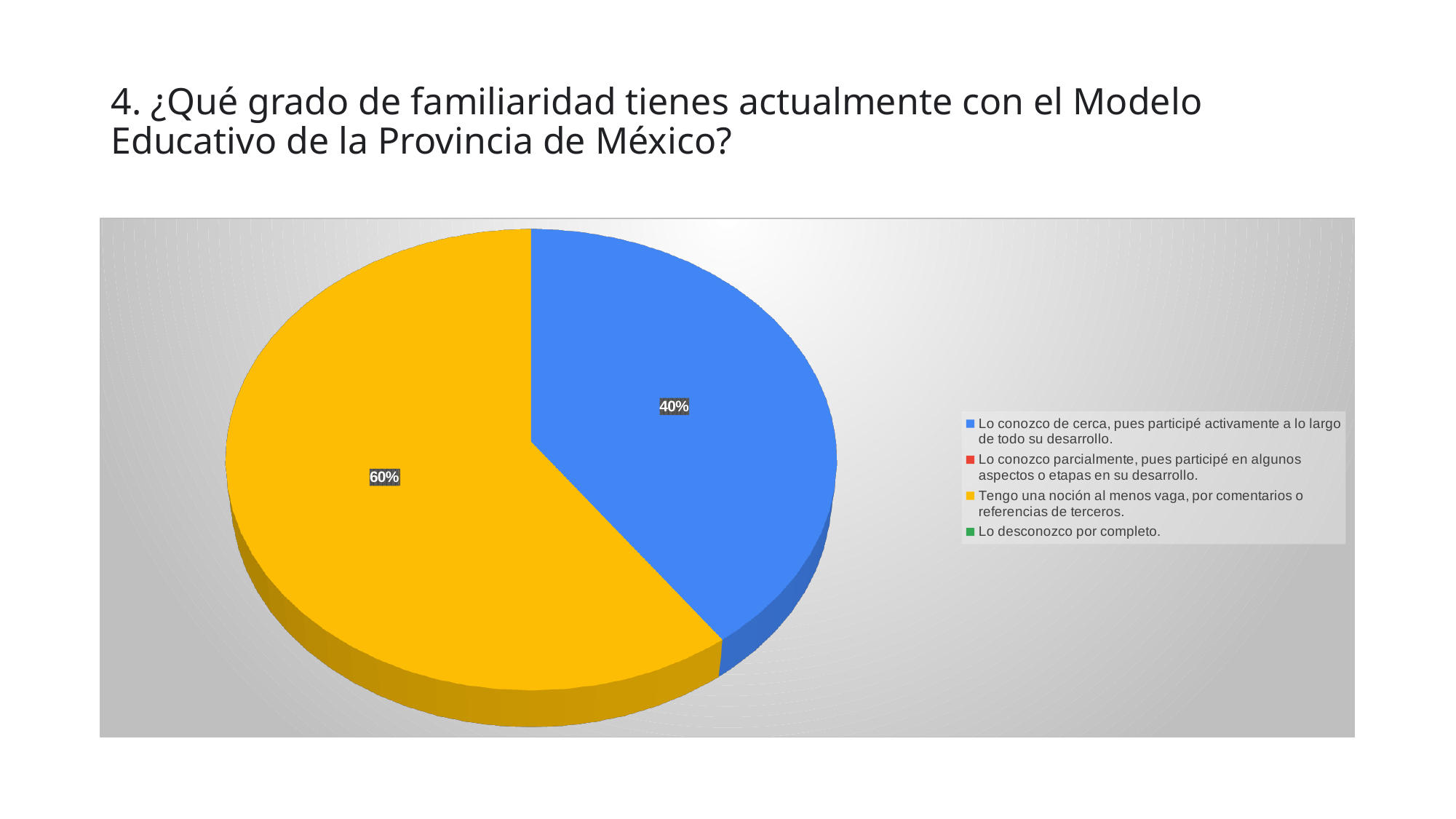
How many slices are visible in the pie? 2 How many entries does the legend list? 4 What colour is the slice labelled 60%? yellow What kind of chart is shown on the slide? pie chart Which category has the largest slice of the pie? Tengo una noción al menos vaga, por comentarios o referencias de terceros. Which is larger: the share for "Lo conozco de cerca" or the share for "Tengo una noción al menos vaga"? Tengo una noción al menos vaga What is the difference in percentage points between the yellow slice and the blue slice? 20% What share of the pie does "Tengo una noción al menos vaga, por comentarios o referencias de terceros." represent? 60% What share of the pie does "Lo conozco de cerca, pues participé activamente a lo largo de todo su desarrollo." represent? 40% Is the share for "Lo conozco de cerca, pues participé activamente a lo largo de todo su desarrollo." greater or less than 50%? less Which legend entry is shown in blue? Lo conozco de cerca, pues participé activamente a lo largo de todo su desarrollo.